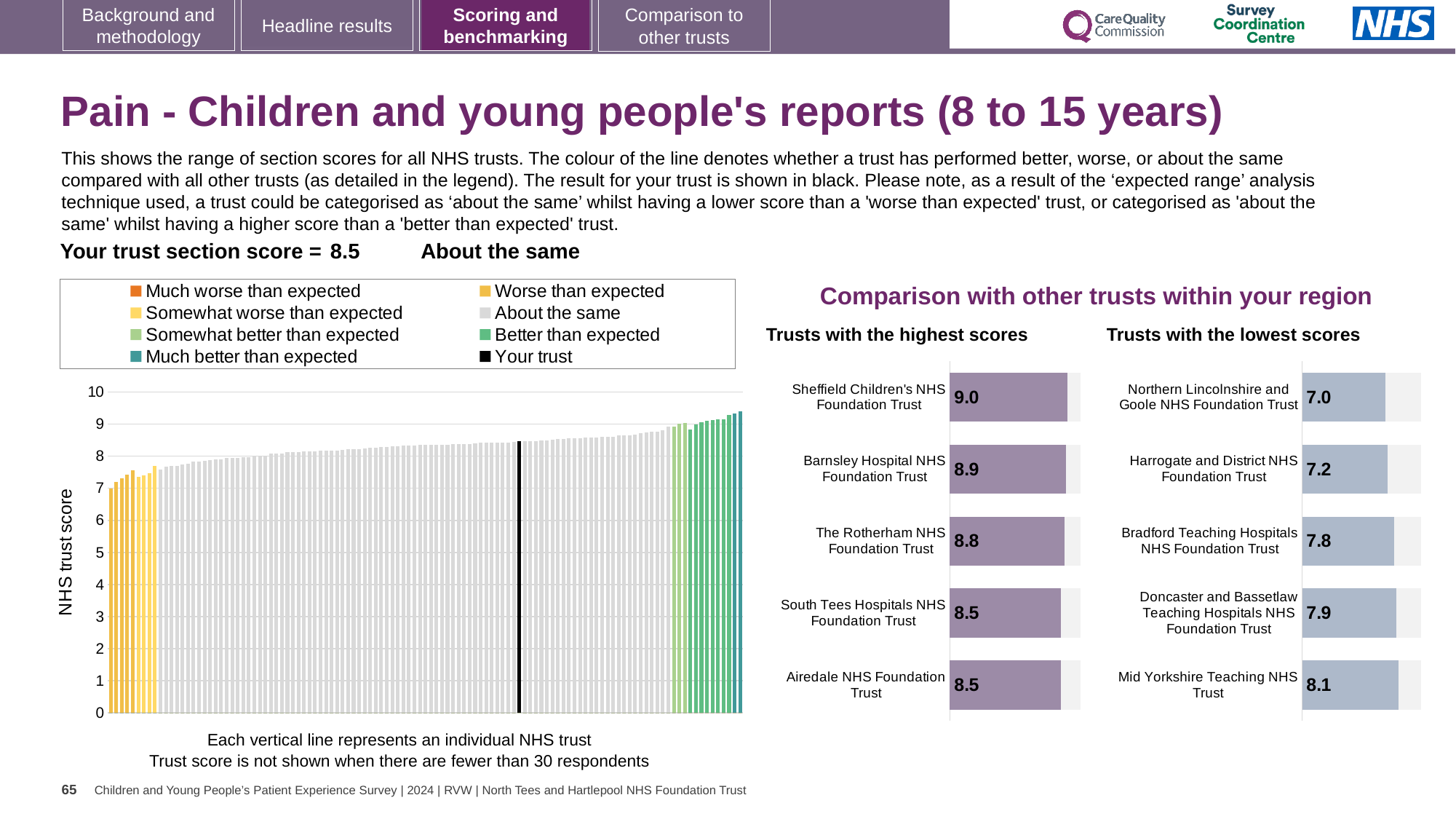
In the 'Trusts with the highest scores' chart, what is the score for The Rotherham NHS Foundation Trust? 8.8 In the 'Trusts with the lowest scores' chart, which trust has the lowest score? Northern Lincolnshire and Goole NHS Foundation Trust In the 'Trusts with the highest scores' chart, what is the score for Sheffield Children's NHS Foundation Trust? 9.0 Which has a higher score: Bradford Teaching Hospitals NHS Foundation Trust in the lowest scores chart or South Tees Hospitals NHS Foundation Trust in the highest scores chart? South Tees Hospitals NHS Foundation Trust How many trusts are listed in the 'Trusts with the highest scores' chart? 5 What type of chart is the large chart on the left showing NHS trust scores? Bar chart How many entries does the legend above the large chart on the left list? 8 In the 'Trusts with the lowest scores' chart, what is the difference between the scores of Mid Yorkshire Teaching NHS Trust and Northern Lincolnshire and Goole NHS Foundation Trust? 1.1 In the 'Trusts with the lowest scores' chart, which trust has the highest score? Mid Yorkshire Teaching NHS Trust In the 'Trusts with the lowest scores' chart, what is the score for Harrogate and District NHS Foundation Trust? 7.2 In the large chart on the left, do the trust scores rise or fall from left to right? Rise In the 'Trusts with the highest scores' chart, what is the difference between the scores of Sheffield Children's NHS Foundation Trust and Barnsley Hospital NHS Foundation Trust? 0.1